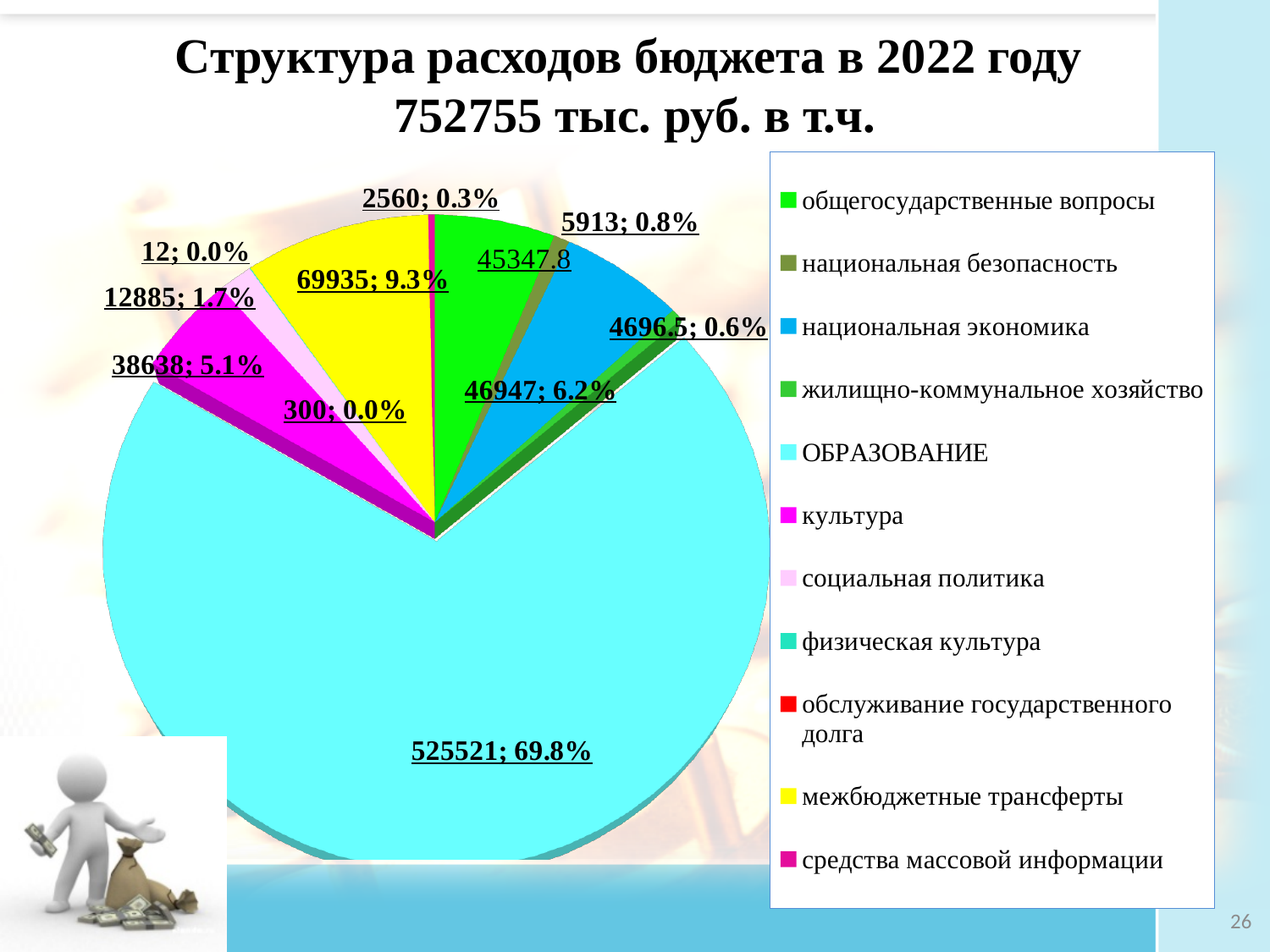
What is the value shown for межбюджетные трансферты? 69935 What total amount in thousand rubles is stated in the chart title? 752755 тыс. руб. What is the value shown for культура? 38638 What is the difference between the values for межбюджетные трансферты and национальная экономика? 22988 What is the value shown for ОБРАЗОВАНИЕ? 525521 What share of the pie does ОБРАЗОВАНИЕ account for? 69.8% What is the value shown for общегосударственные вопросы? 45347.8 Which category has the largest slice of the pie chart? ОБРАЗОВАНИЕ What share of the pie does национальная экономика account for? 6.2% Which is larger, the value for национальная экономика or the value for культура? национальная экономика What kind of chart is shown on the slide? pie chart How many categories does the legend of the pie chart list? 11